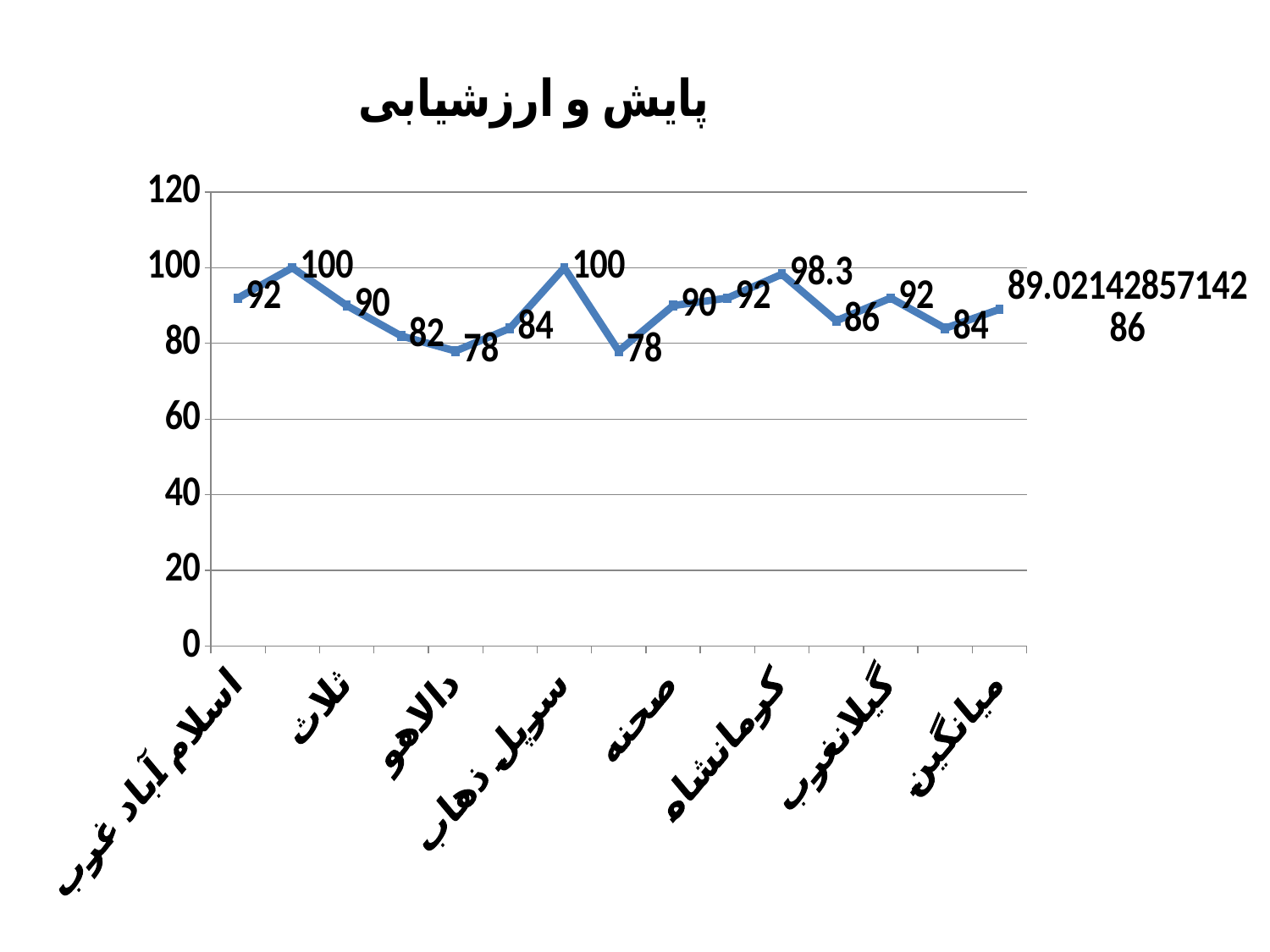
What is the value for اسلام آباد غرب? 92 What is the value for میانگین? 89.0214285714286 What is the highest value plotted on the chart? 100 What is the difference between the values for سرپل ذهاب and دالاهو? 22 What is the value for سرپل ذهاب? 100 Which has a larger value, کرمانشاه or گیلانغرب? کرمانشاه What type of chart is shown on the slide? line chart What is the value for دالاهو? 78 What is the title of the chart? پایش و ارزشیابی What is the value for کرمانشاه? 98.3 How many data points are plotted on the line? 15 What is the lowest value plotted on the chart? 78